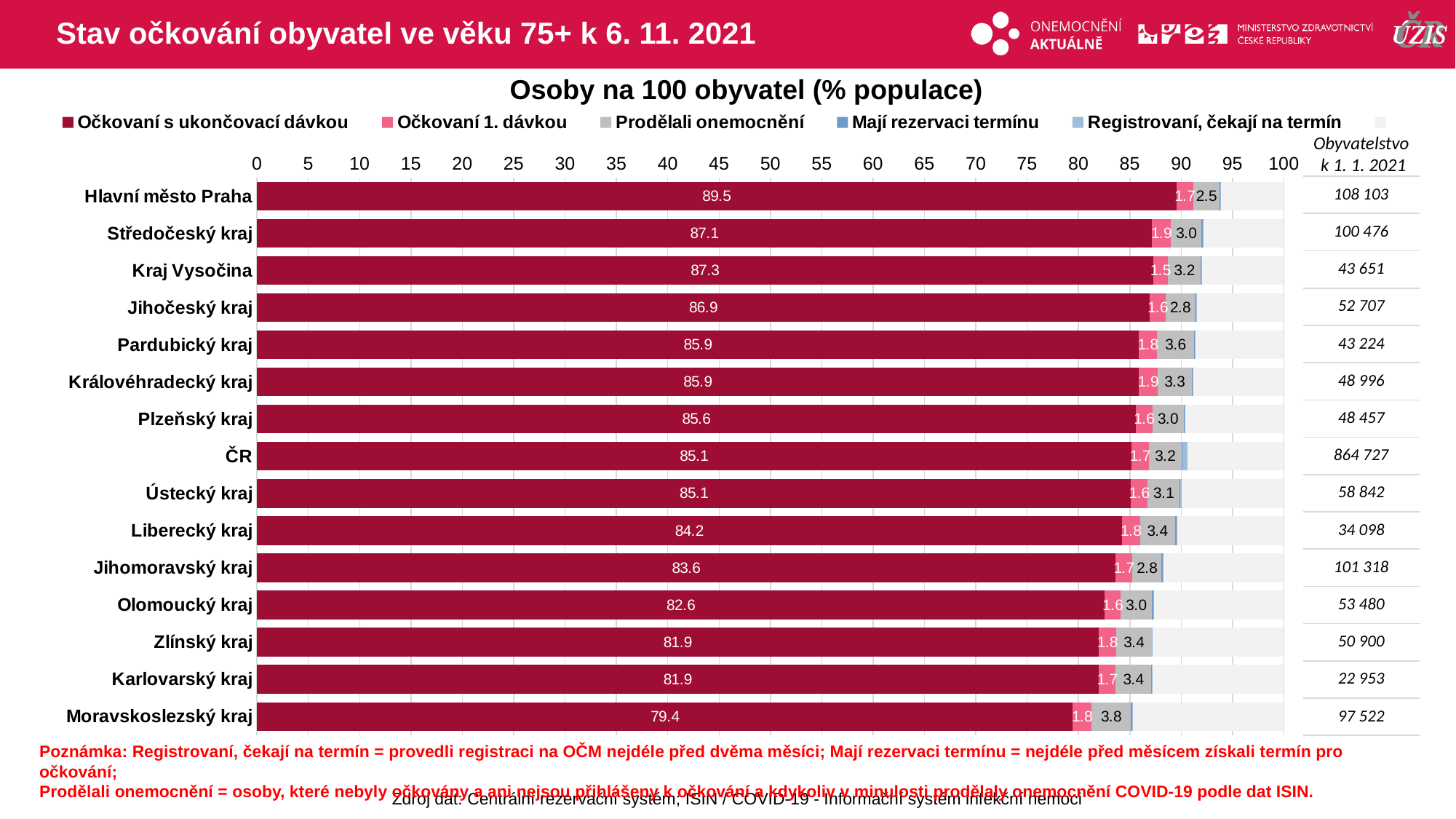
Which has a higher value of 'Očkovaní s ukončovací dávkou': Kraj Vysočina or Středočeský kraj? Kraj Vysočina What is the value of 'Očkovaní s ukončovací dávkou' for Hlavní město Praha? 89.5 Is the value of 'Očkovaní s ukončovací dávkou' for Olomoucký kraj greater or less than 85? less What is the difference in 'Očkovaní s ukončovací dávkou' between Hlavní město Praha and Moravskoslezský kraj? 10.1 Which region has the lowest value of 'Očkovaní s ukončovací dávkou'? Moravskoslezský kraj How many categories (rows) are plotted in the chart? 15 Which region has the lowest value of 'Prodělali onemocnění'? Hlavní město Praha What is the value of 'Prodělali onemocnění' for Moravskoslezský kraj? 3.8 Which region has the highest value of 'Očkovaní s ukončovací dávkou'? Hlavní město Praha What is the value of 'Očkovaní 1. dávkou' for Středočeský kraj? 1.9 What is the title of the chart? Osoby na 100 obyvatel (% populace) What kind of chart is shown on the slide? Stacked bar chart